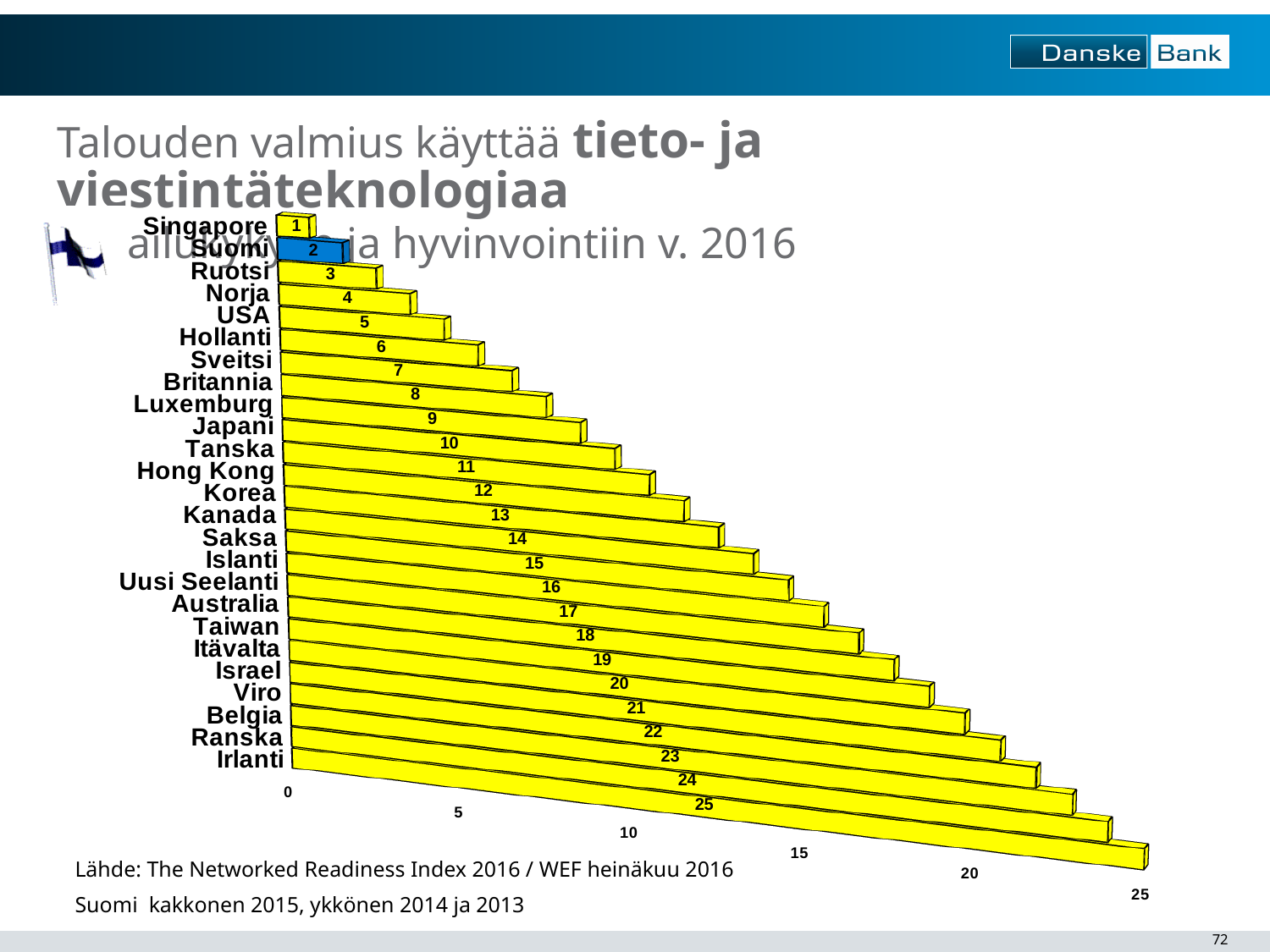
Which country has the highest value on the chart? Irlanti What value is shown for Irlanti? 25 Is the value for Viro greater or less than 20? greater What value is shown for Japani? 10 Which has the larger value, Kanada or Hollanti? Kanada How many countries are shown on the chart? 25 Which country's bar is coloured blue instead of yellow? Suomi What is the difference between the values for Ranska and Ruotsi? 21 What kind of chart is shown on the slide? bar chart What value is shown for Suomi? 2 Which country has the lowest value on the chart? Singapore What value is shown for Uusi Seelanti? 17